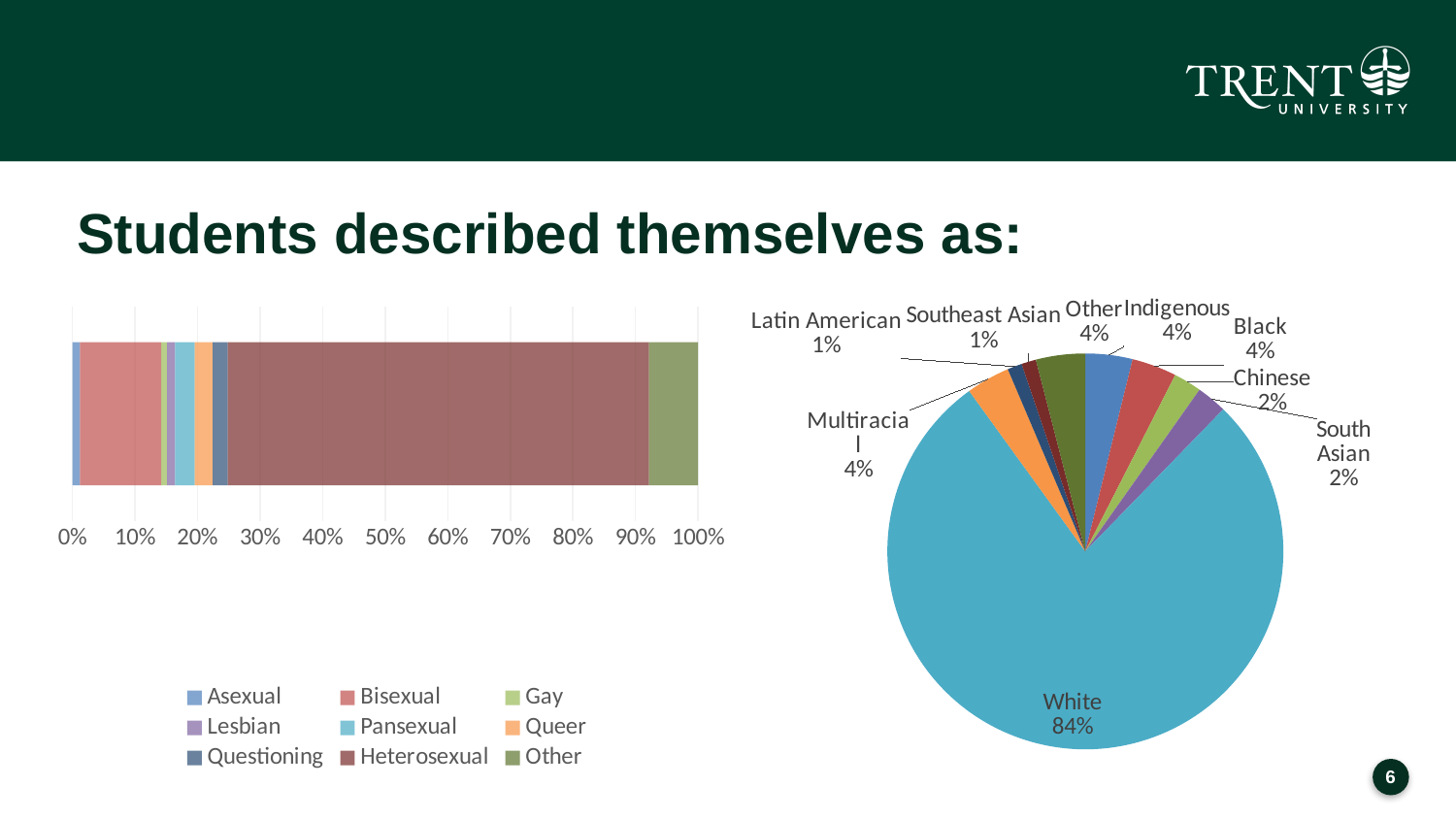
In the pie chart on the right, what is the value for Latin American? 1% In the stacked bar chart on the left, which segment is larger, Bisexual or Asexual? Bisexual In the pie chart on the right, how many slices are there? 9 In the pie chart on the right, what is the difference between the White and Black percentages? 80% In the pie chart on the right, which is larger, Black or Chinese? Black In the pie chart on the right, which category has the largest slice? White In the pie chart on the right, what percentage of students described themselves as White? 84% How many series does the legend of the chart on the left list? 9 In the pie chart on the right, what is the value for Black? 4% In the stacked bar chart on the left, which category takes up the largest portion of the bar? Heterosexual In the pie chart on the right, what is the value for Chinese? 2% What kind of chart is the chart on the left of the slide? Bar chart